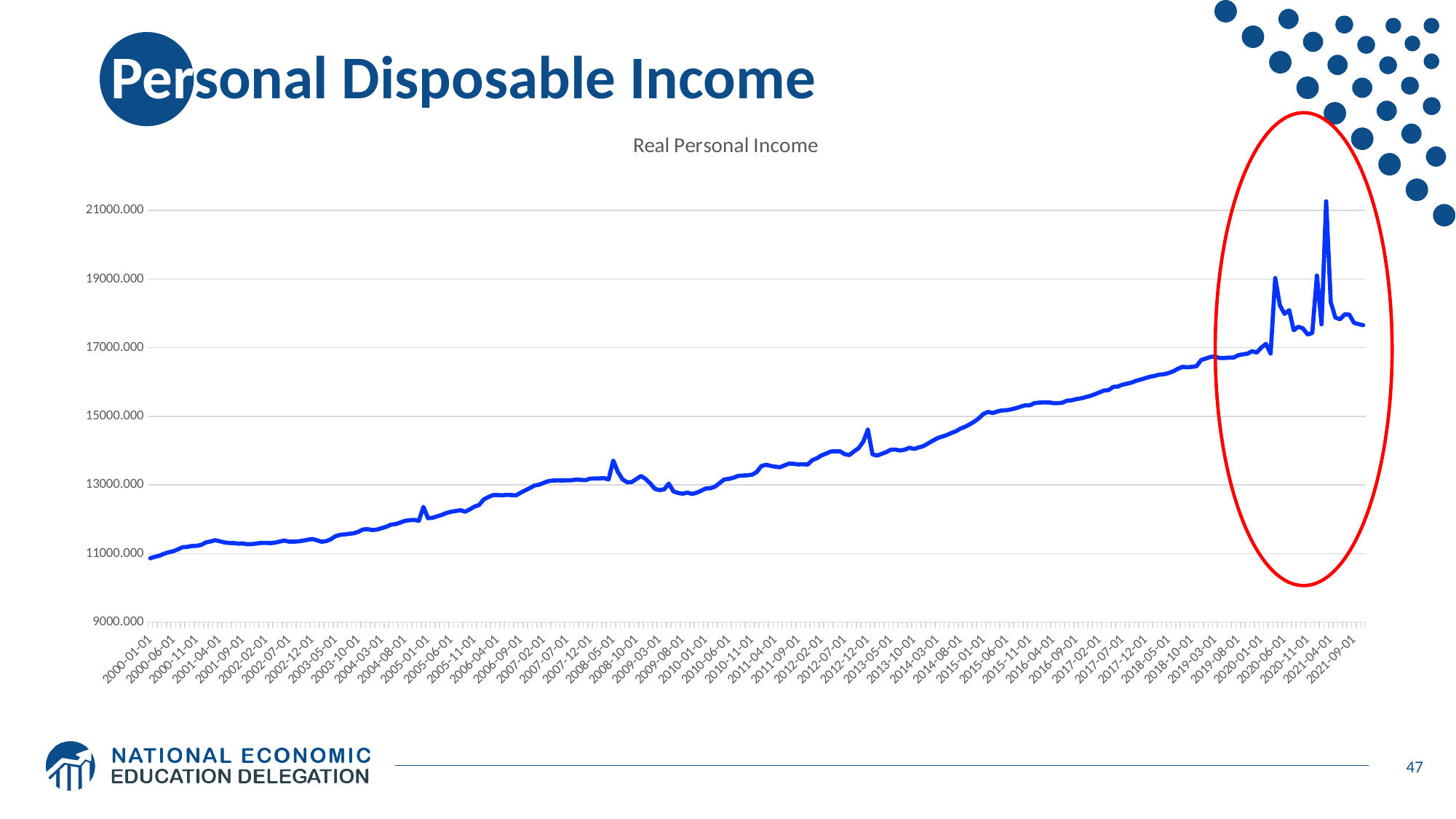
Is the value at 2005-06-01 greater or less than 13000.000? less What colour is the shape drawn around the 2020-2021 portion of the line? red Is the highest peak of the line greater or less than 19000.000? greater What is the title of the chart? Real Personal Income Is the value at 2021-09-01 greater or less than 17000.000? greater Which is larger, the value at 2020-01-01 or the value at 2010-01-01? 2020-01-01 Overall, do the values rise or fall from 2000 to 2021 along the x axis? rise What kind of chart is shown on the slide? line chart In which year does the highest value of the line occur? 2021 At which date on the x axis is the line at its lowest value? 2000-01-01